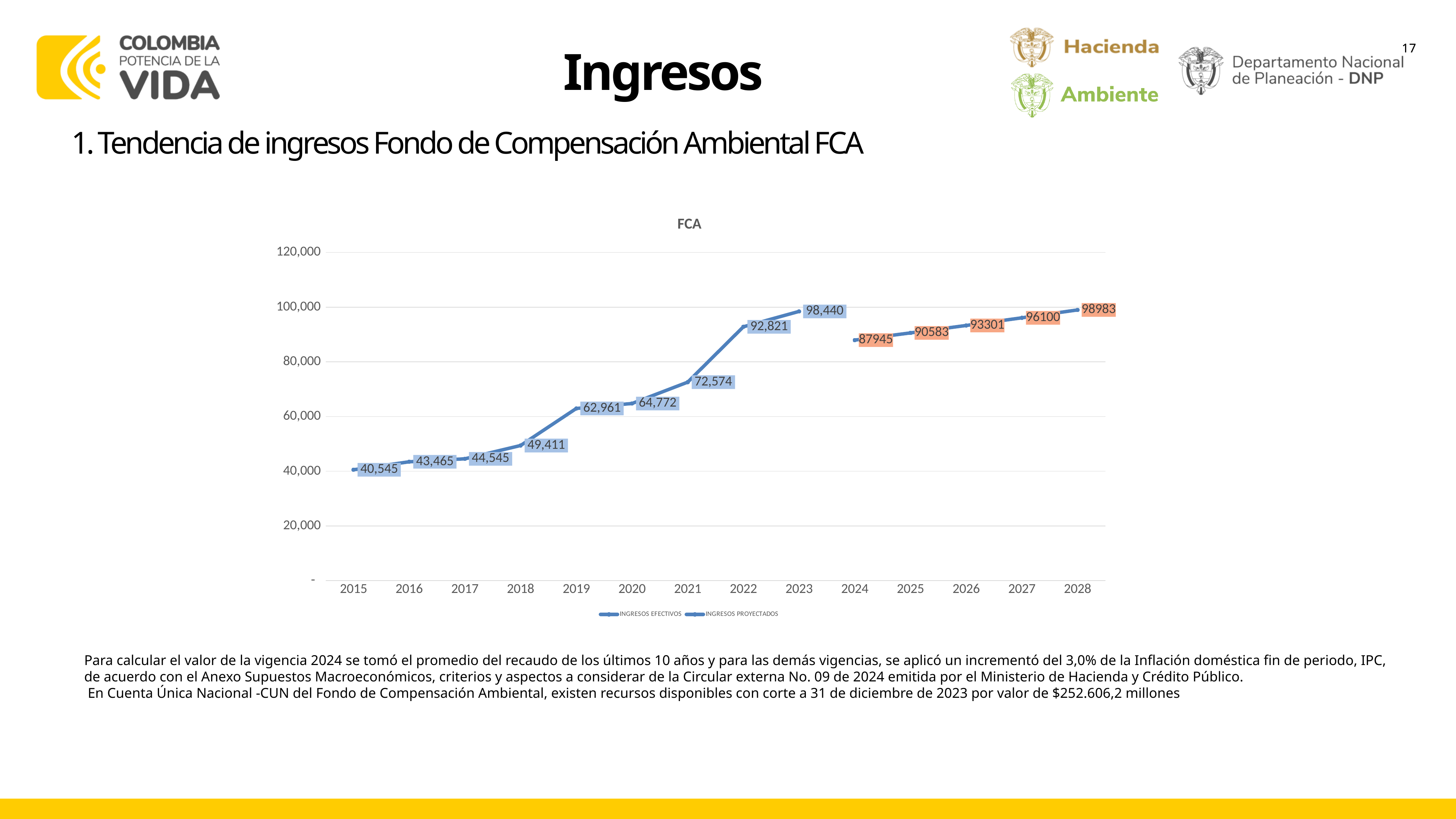
What is the projected value for 2026 in the FCA chart? 93301 What kind of chart is the FCA chart? line chart What is the difference between the 2023 value and the 2022 value in the FCA chart? 5,619 What is the value for 2015 in the FCA chart? 40,545 Which year has the lowest value in the FCA chart? 2015 Which is larger in the FCA chart, the value for 2023 or the projected value for 2024? 2023 Which year has the highest value among the INGRESOS EFECTIVOS series in the FCA chart? 2023 What is the difference between the projected values for 2028 and 2024 in the FCA chart? 11038 How many series does the legend of the FCA chart list? 2 Is the value for 2021 in the FCA chart greater or less than 80,000? less What is the value for 2022 in the FCA chart? 92,821 How many years are shown on the x axis of the FCA chart? 14